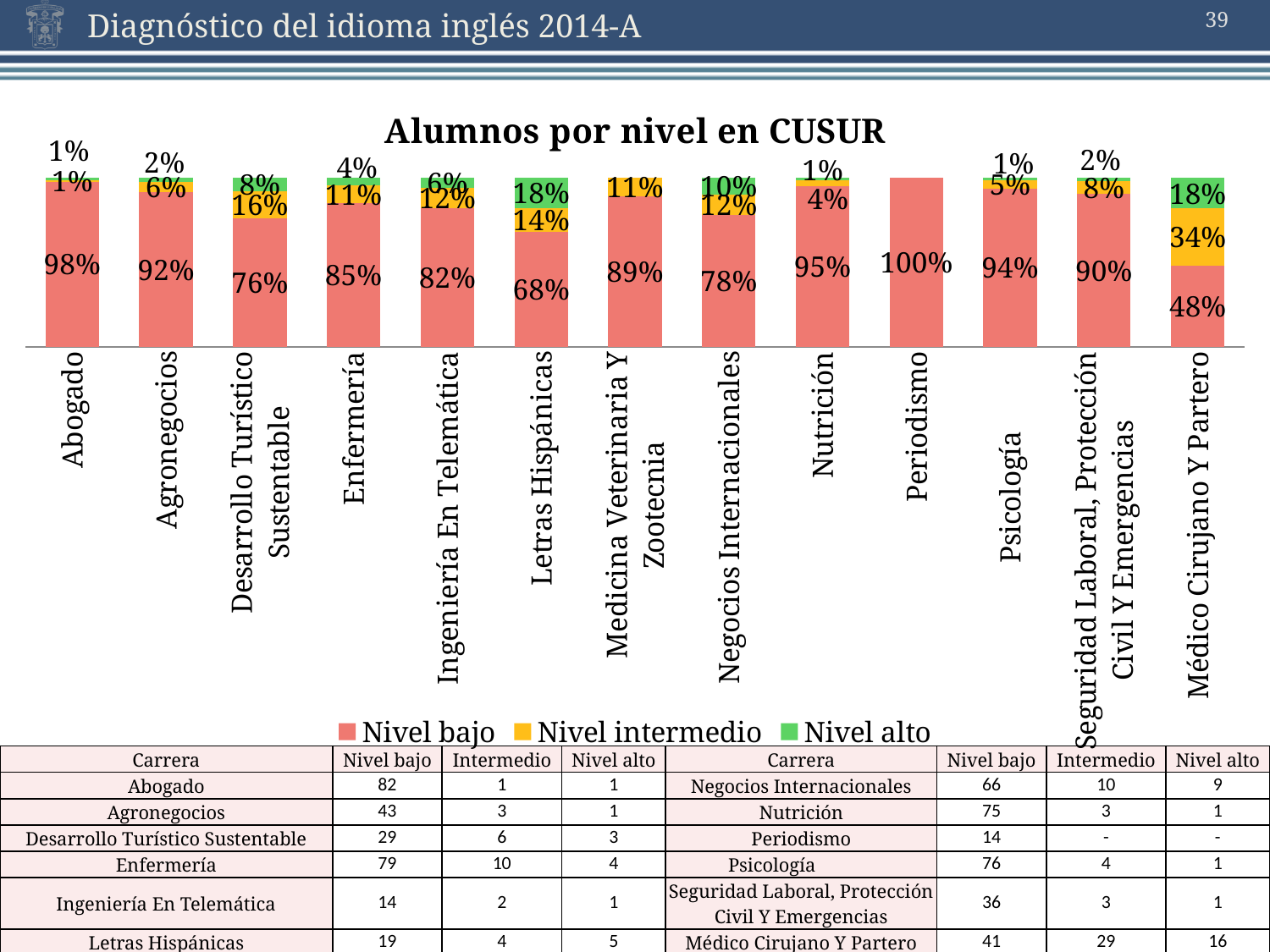
What is the Nivel alto percentage for Letras Hispánicas? 18% What is the difference between the Nivel bajo percentage for Abogado and for Agronegocios? 6% Which carrera has the lowest Nivel bajo percentage? Médico Cirujano Y Partero How many series does the chart legend list? 3 What is the total of the three segments in the bar for Médico Cirujano Y Partero? 100% What is the Nivel bajo percentage for Médico Cirujano Y Partero? 48% What is the title of the chart? Alumnos por nivel en CUSUR What type of chart is shown on the slide? Stacked bar chart Which carrera has the highest Nivel bajo percentage? Periodismo How many carreras (categories) are shown on the x axis of the chart? 13 Which has a larger Nivel intermedio percentage, Médico Cirujano Y Partero or Letras Hispánicas? Médico Cirujano Y Partero What is the Nivel intermedio percentage for Desarrollo Turístico Sustentable? 16%